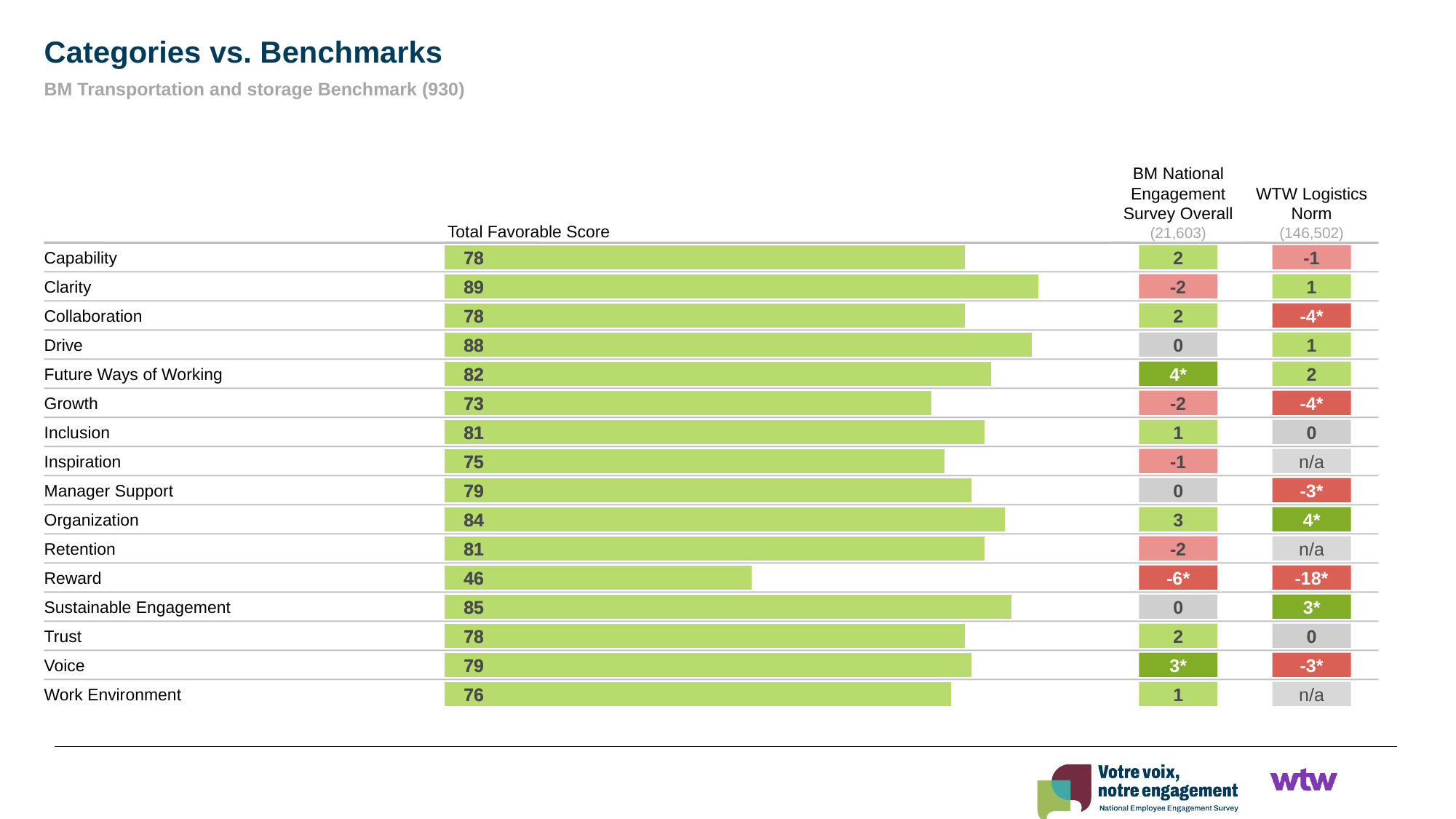
What is the Total Favorable Score for Sustainable Engagement? 85 What is the difference between the Total Favorable Scores for Drive and Growth? 15 How many categories are shown in the chart? 16 What is the Total Favorable Score for Reward? 46 Which category has the highest Total Favorable Score? Clarity What is the Total Favorable Score for Clarity? 89 Which has a higher Total Favorable Score, Organization or Inspiration? Organization Which category has the lowest Total Favorable Score? Reward What kind of chart is used to show the Total Favorable Score? Bar chart What is the value shown for Reward in the WTW Logistics Norm column? -18* What is the difference between the Total Favorable Scores for Clarity and Reward? 43 What is the value shown for Future Ways of Working in the BM National Engagement Survey Overall column? 4*